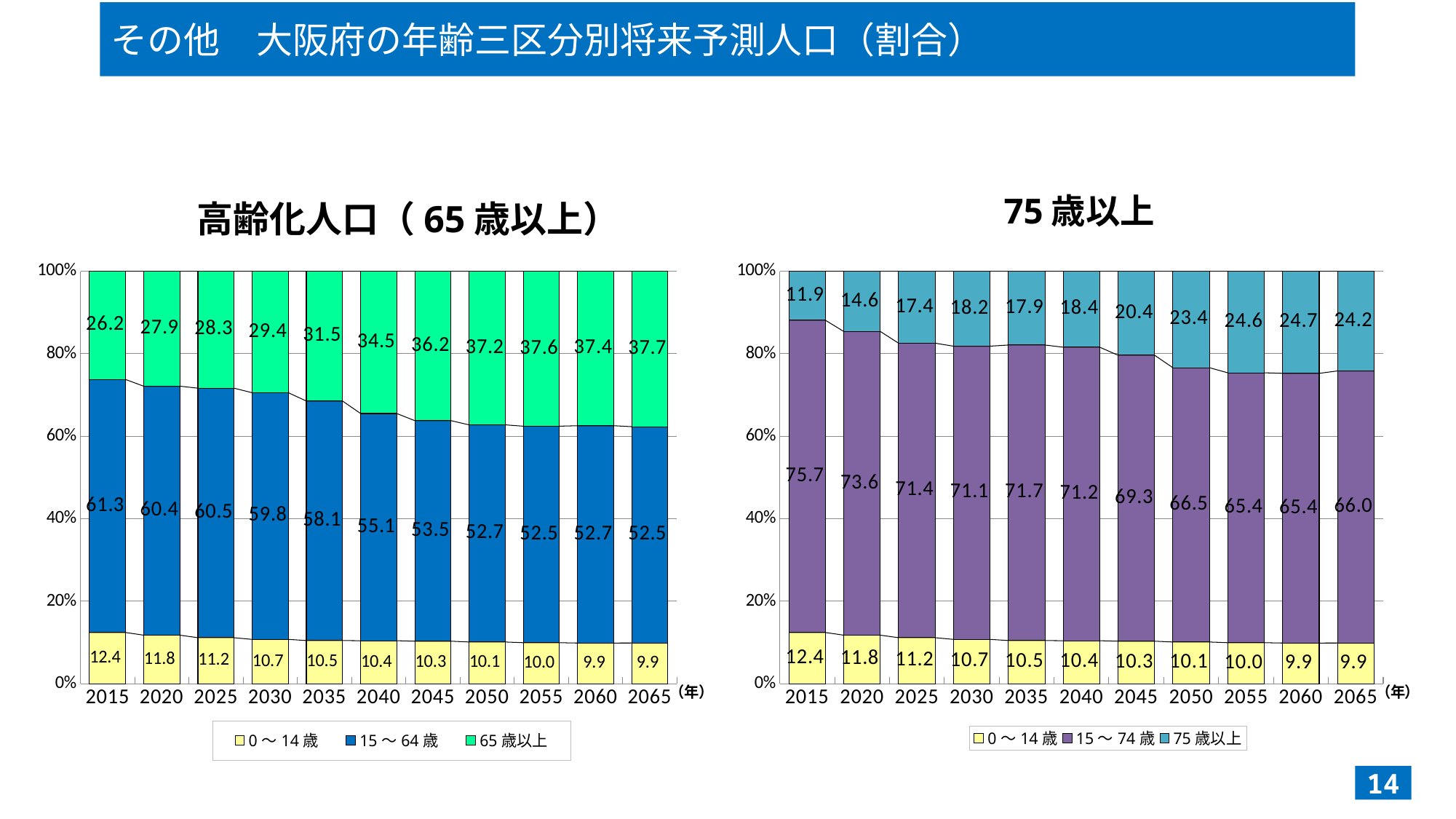
In the left chart (高齢化人口（65歳以上）), what is the value for 15～64歳 in 2040? 55.1 What kind of chart is the left chart (高齢化人口（65歳以上）)? Stacked bar chart In the right chart (75歳以上), what is the value for 15～74歳 in 2035? 71.7 How many series does the legend of the right chart (75歳以上) list? 3 In the left chart (高齢化人口（65歳以上）), what is the value for 65歳以上 in 2015? 26.2 In the left chart (高齢化人口（65歳以上）), does the 0～14歳 value rise or fall from 2015 to 2065? Fall In the right chart (75歳以上), which year has the lowest value for 75歳以上? 2015 In the right chart (75歳以上), which is larger: the 75歳以上 value in 2050 or in 2045? 2050 How many years are shown on the x axis of the left chart (高齢化人口（65歳以上）)? 11 In the right chart (75歳以上), what is the value for 75歳以上 in 2065? 24.2 In the left chart (高齢化人口（65歳以上）), what is the difference between the 65歳以上 values for 2065 and 2015? 11.5 In the left chart (高齢化人口（65歳以上）), which year has the highest value for 65歳以上? 2065